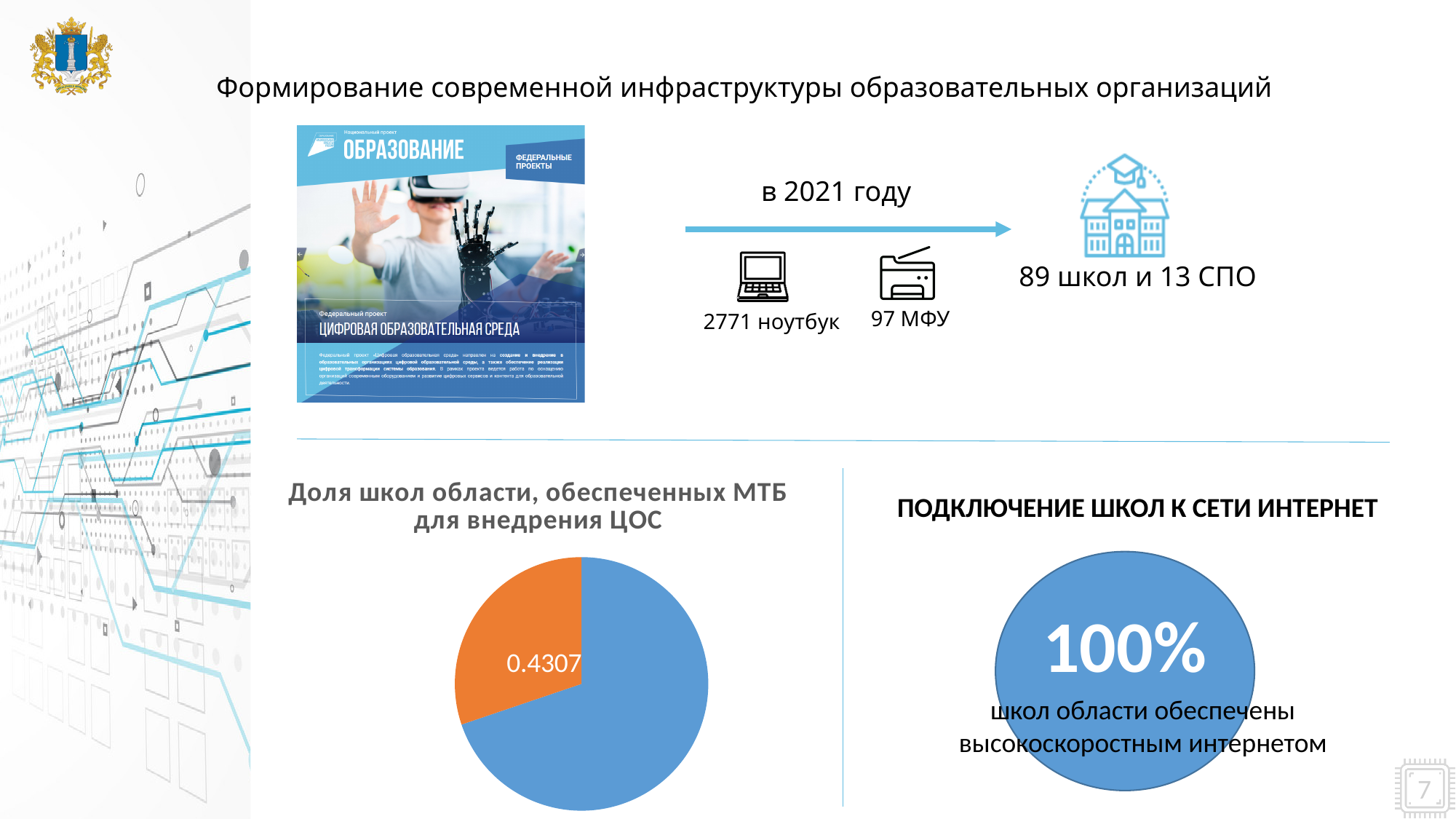
How many slices does the pie chart "Доля школ области, обеспеченных МТБ для внедрения ЦОС" have? 2 Which slice of the pie chart is larger, the blue one or the orange one? blue What kind of chart is shown under the title "Доля школ области, обеспеченных МТБ для внедрения ЦОС"? pie chart What value is printed on the orange slice of the pie chart? 0.4307 What is the title of the pie chart on the slide? Доля школ области, обеспеченных МТБ для внедрения ЦОС Is the orange slice of the pie chart more or less than half of the pie? less Which two colours are used for the slices of the pie chart? blue and orange Which slice of the pie chart is the smallest? the orange slice Does the blue slice of the pie chart have a data label printed on it? No